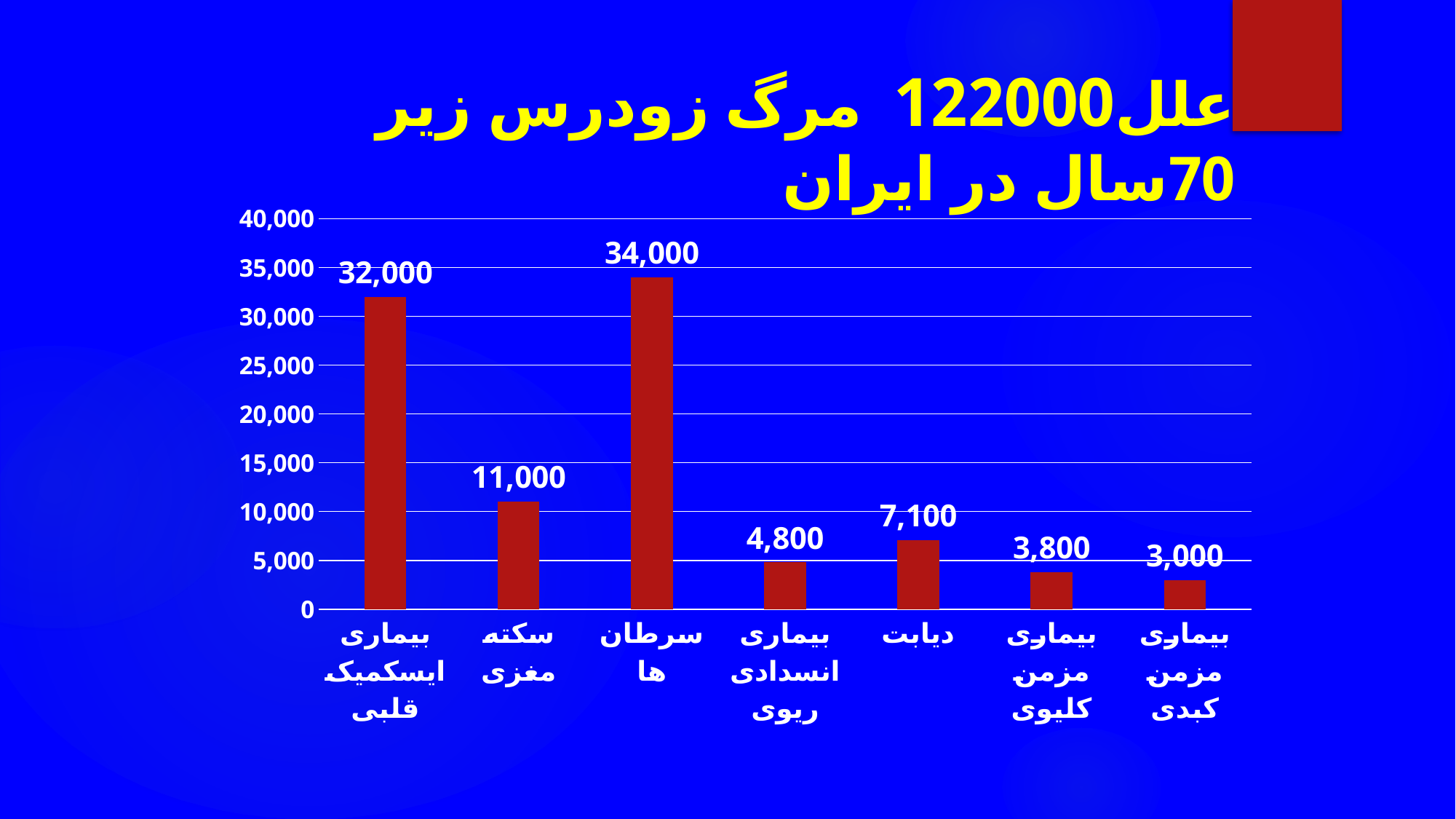
What is the difference between the values for سرطان ها and بیماری ایسکمیک قلبی? 2,000 Which category has the lowest value? بیماری مزمن کبدی What is the difference between the values for سکته مغزی and دیابت? 3,900 What kind of chart is shown on the slide? bar chart Which category has the highest value? سرطان ها What is the value for دیابت? 7,100 What is the value for بیماری مزمن کبدی? 3,000 Is the value for سکته مغزی greater or less than 10,000? greater What is the value for سرطان ها? 34,000 How many categories are shown on the x axis? 7 Which is larger, the value for بیماری انسدادی ریوی or the value for دیابت? دیابت What is the value for بیماری ایسکمیک قلبی? 32,000